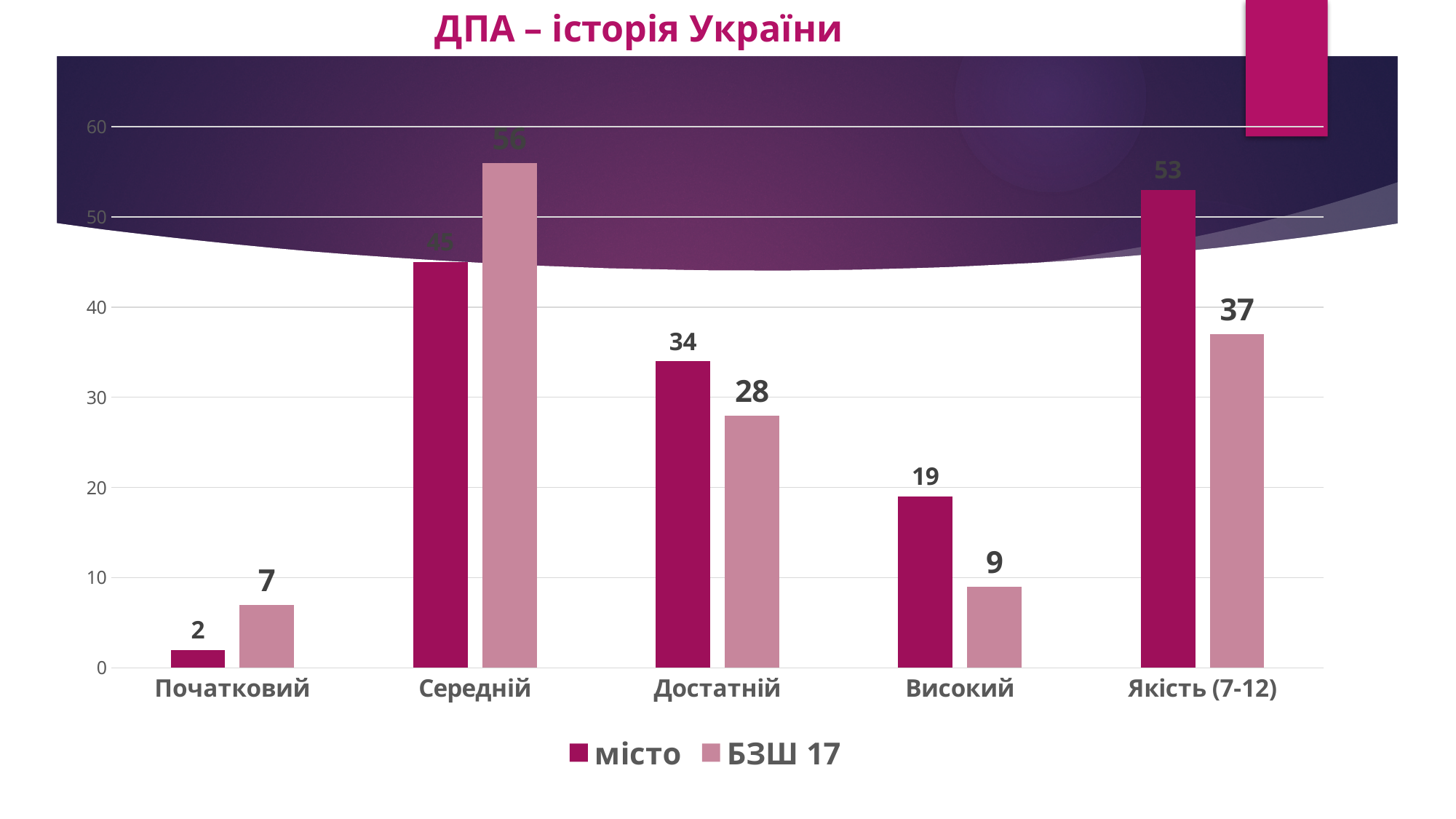
What is the value for місто in the Середній category? 45 Is the value for БЗШ 17 in the Середній category greater or less than 50? greater How many categories are shown on the x axis? 5 Which category has the lowest value for місто? Початковий What is the difference between місто and БЗШ 17 in the Якість (7-12) category? 16 Which is larger in the Високий category: місто or БЗШ 17? місто What is the value for БЗШ 17 in the Достатній category? 28 How many series does the legend list? 2 Which category has the highest value for БЗШ 17? Середній What kind of chart is shown on the slide? bar chart What is the value for місто in the Якість (7-12) category? 53 What is the title of the chart? ДПА – історія України